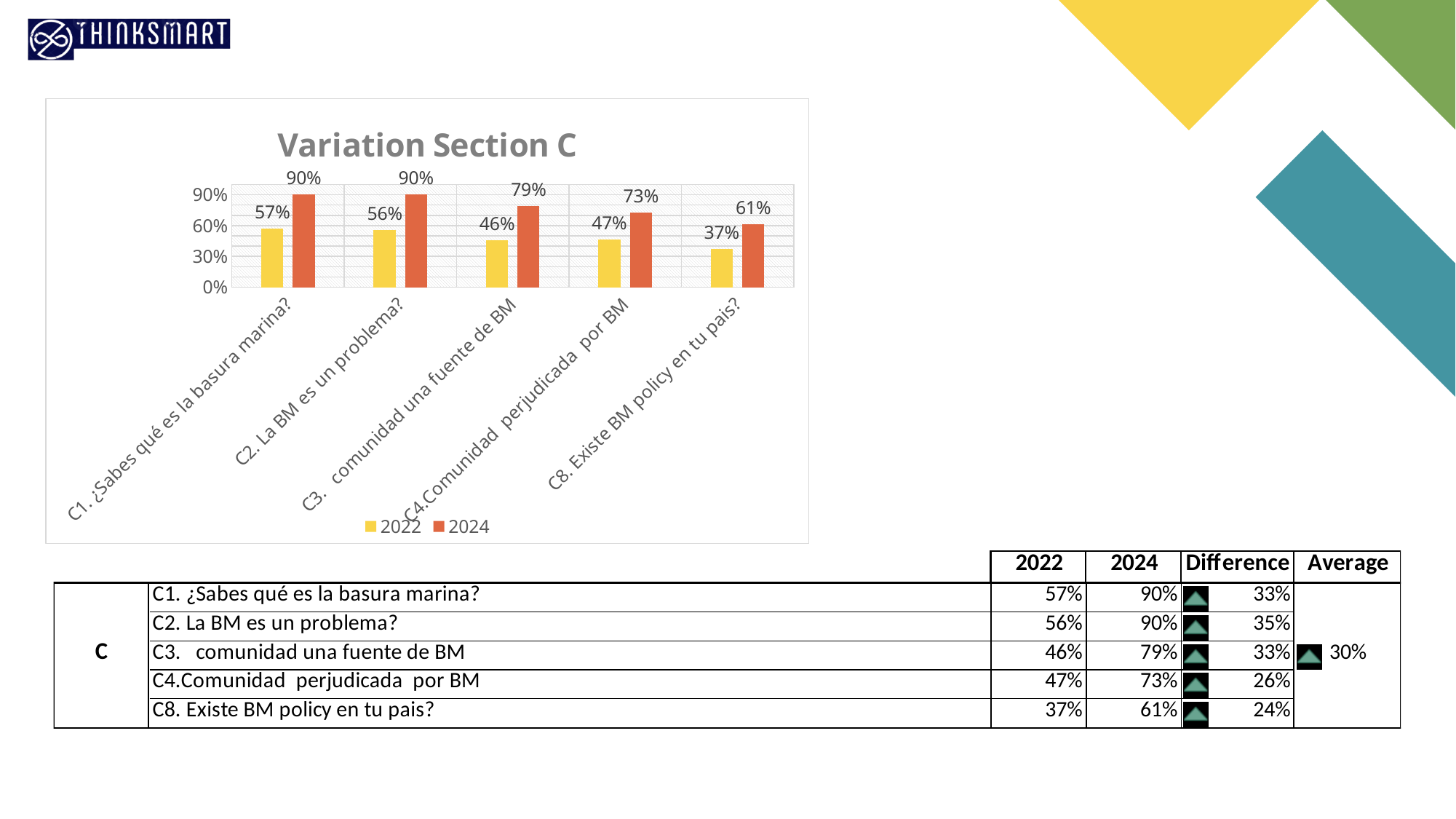
How many series does the legend list? 2 What is the 2024 value for C3. comunidad una fuente de BM? 79% What is the difference between the 2024 and 2022 values for C4.Comunidad perjudicada por BM? 26% What is the 2022 value for C1. ¿Sabes qué es la basura marina? 57% What is the difference between the 2024 and 2022 values for C2. La BM es un problema? 34% Which is larger: the 2022 value for C1. ¿Sabes qué es la basura marina? or the 2022 value for C3. comunidad una fuente de BM? C1. ¿Sabes qué es la basura marina? Which category has the lowest 2024 value? C8. Existe BM policy en tu pais? Which category has the lowest 2022 value? C8. Existe BM policy en tu pais? What kind of chart is shown? Bar chart What is the title of the chart? Variation Section C How many categories are shown on the x axis? 5 What is the 2022 value for C8. Existe BM policy en tu pais? 37%